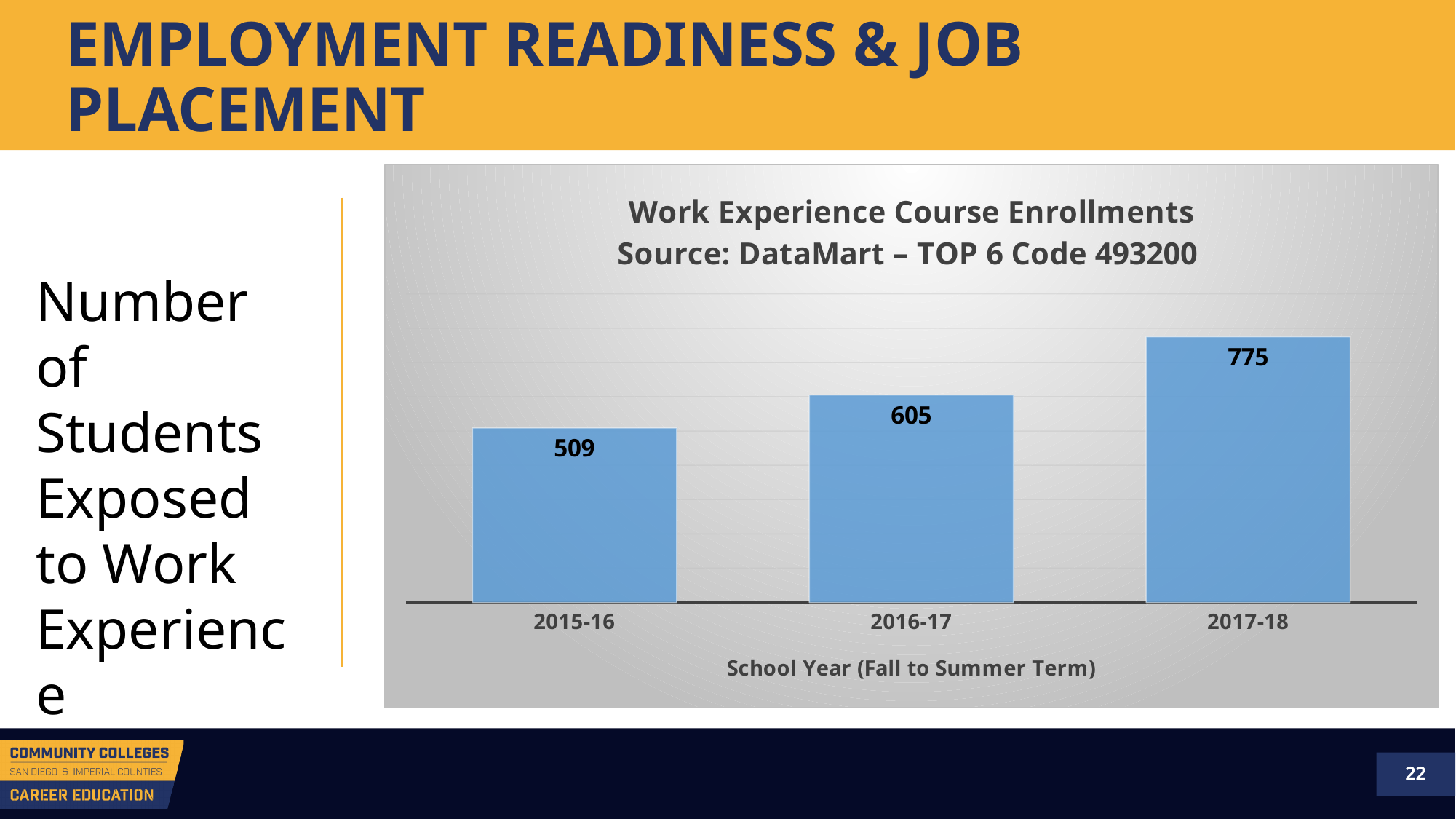
What is the difference between the values for 2016-17 and 2015-16? 96 Which school year has the lowest number of work experience course enrollments? 2015-16 What is the value for 2015-16? 509 What is the value for 2016-17? 605 What kind of chart is shown on the slide? Bar chart Which school year has the highest number of work experience course enrollments? 2017-18 What is the value for 2017-18? 775 How many school years are shown on the chart? 3 What is the label of the x axis on the chart? School Year (Fall to Summer Term) Which is larger, the value for 2016-17 or the value for 2017-18? 2017-18 Do the enrollment values rise or fall from 2015-16 to 2017-18? Rise What is the difference between the values for 2017-18 and 2015-16? 266